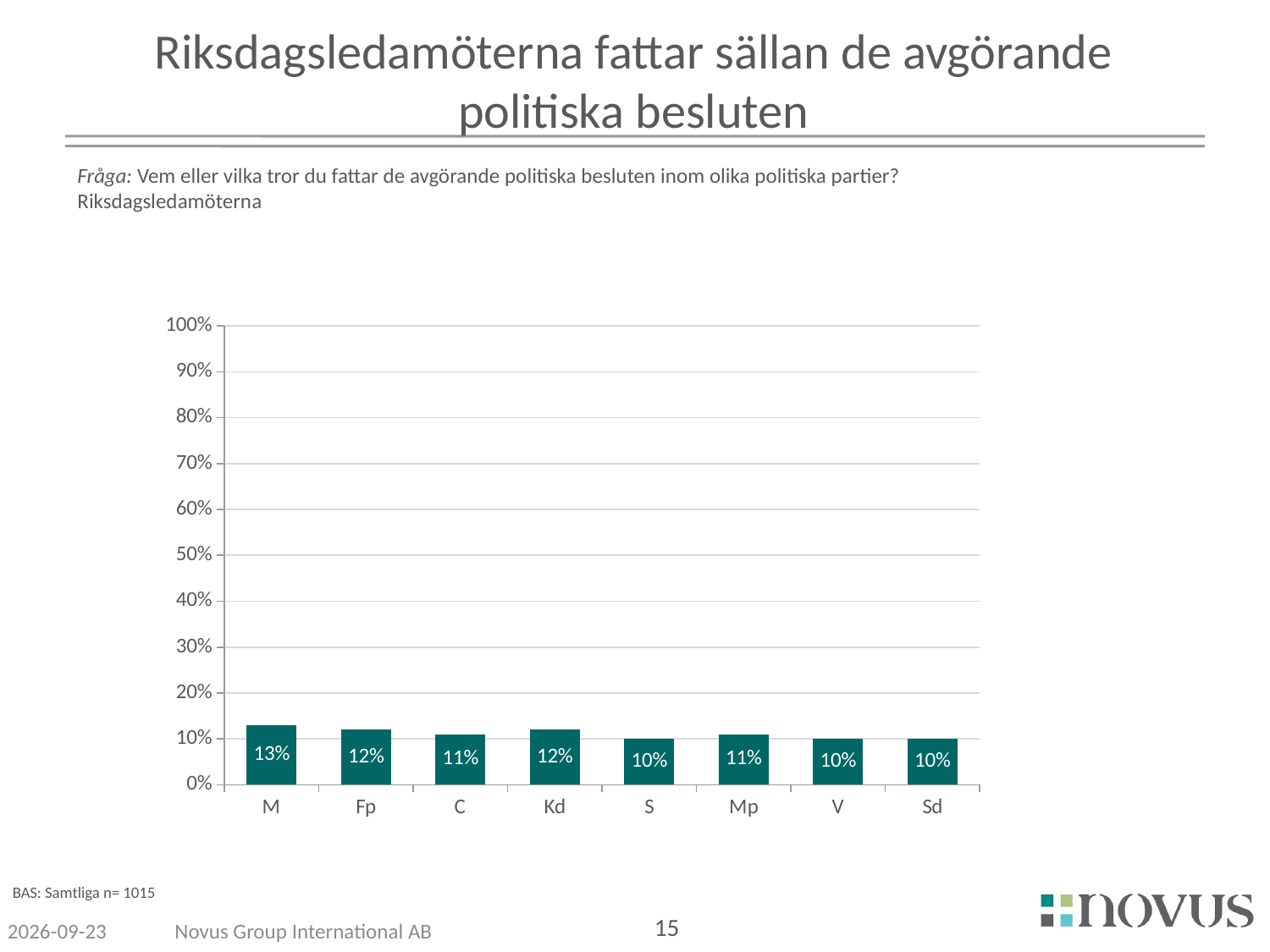
Which is larger, the value for M or the value for S? M What is the highest value shown on the y axis? 100% How many categories are shown on the x axis? 8 What is the value for Sd? 10% What is the difference between the values for Fp and V? 2 percentage points Is the value for M greater or less than 20%? less What is the difference between the values for M and S? 3 percentage points What kind of chart is shown on the slide? bar chart What is the value for M? 13% Which category has the highest value? M What is the value for Kd? 12% What is the value for Mp? 11%